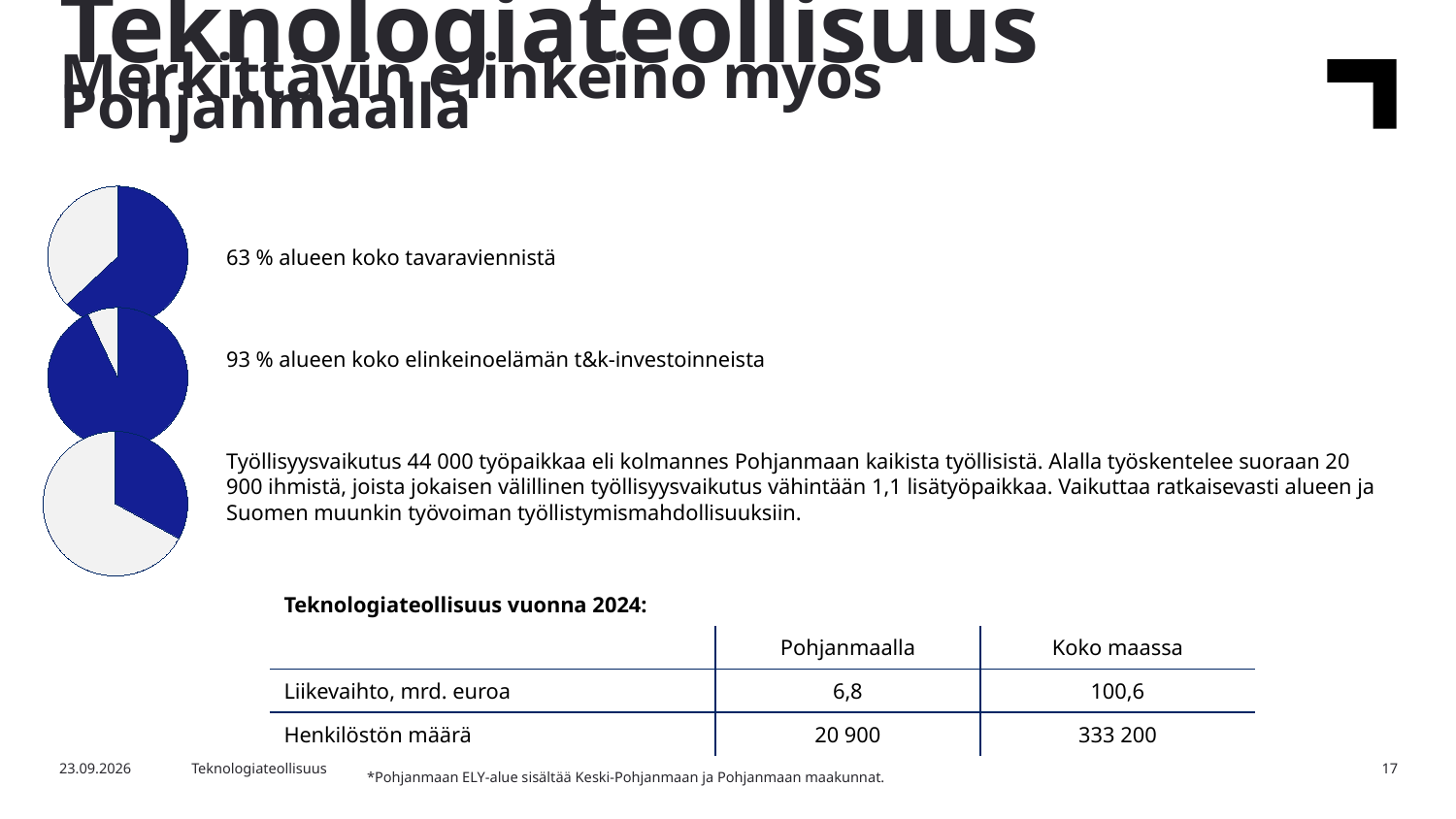
In the middle pie chart, what share of the region's business R&D investments does the blue slice represent? 93 % What text accompanies the top pie chart? 63 % alueen koko tavaraviennistä Is the blue slice in the middle pie chart greater or less than half of the pie? Greater What kind of charts are shown on the left side of the slide? Pie charts In the top pie chart, what share of the region's total goods exports does the blue slice represent? 63 % Is the blue slice in the bottom pie chart greater or less than half of the pie? Less Which has a larger blue share: the top pie chart or the bottom pie chart? Top pie chart What colour is used for the highlighted slice in each pie chart? Blue How many pie charts are on the slide? 3 What is the difference in percentage points between the blue share of the middle pie chart (93 %) and the top pie chart (63 %)? 30 percentage points Which pie chart has the largest blue slice: the top, middle or bottom one? Middle Which pie chart has the smallest blue slice: the top, middle or bottom one? Bottom